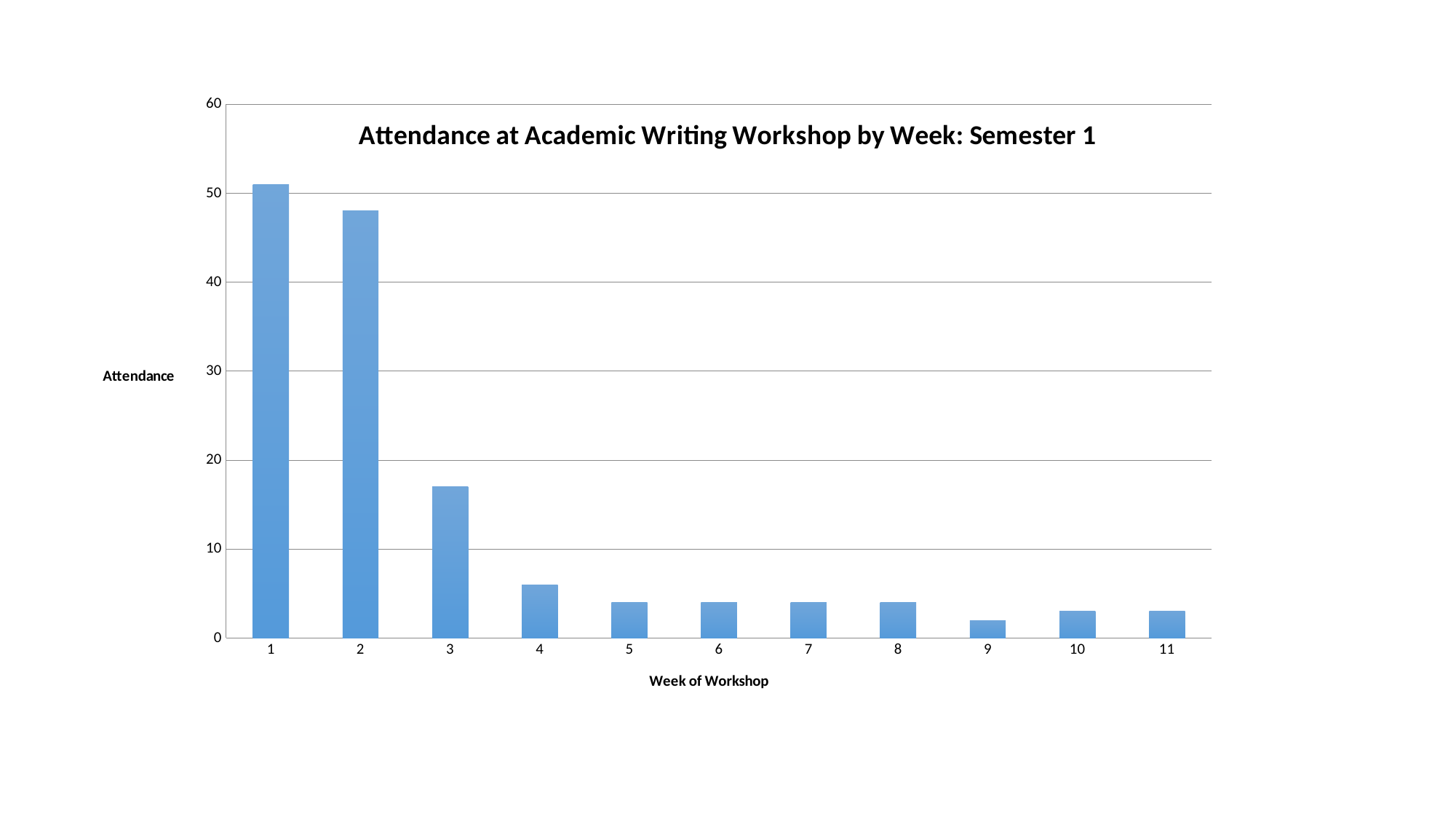
Which week has higher attendance, week 3 or week 4? 3 Does attendance generally rise or fall from week 1 to week 11? fall What kind of chart is shown on the slide? bar chart What is the title of the chart? Attendance at Academic Writing Workshop by Week: Semester 1 Is the attendance for week 3 greater or less than 20? less What is the label on the x axis? Week of Workshop Which week has the lowest attendance? 9 Is the attendance for week 2 greater or less than 50? less How many weeks are plotted on the x axis? 11 Is the attendance for week 1 greater or less than 50? greater Which week has the highest attendance? 1